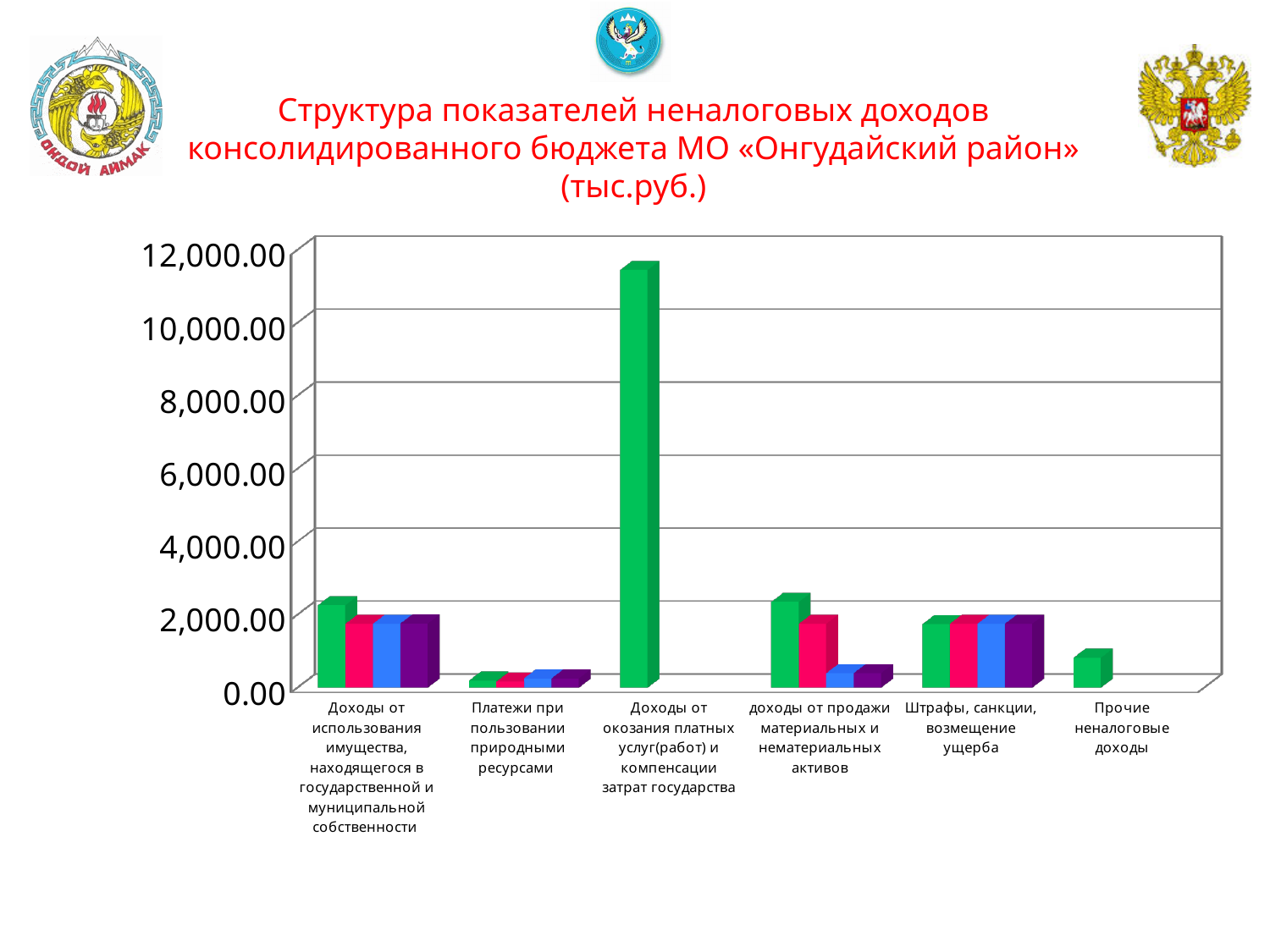
Is the green bar for 'Доходы от использования имущества, находящегося в государственной и муниципальной собственности' greater or less than 4,000.00? less Which category has the shortest green bar in the chart? Платежи при пользовании природными ресурсами Is the green bar for 'Прочие неналоговые доходы' greater or less than 2,000.00? less Is the green bar for 'Доходы от оказания платных услуг(работ) и компенсации затрат государства' greater or less than 10,000.00? greater What colour is the tallest bar in the chart? green What kind of chart is shown on the slide? bar chart Which green bar is taller: 'Штрафы, санкции, возмещение ущерба' or 'Доходы от оказания платных услуг(работ) и компенсации затрат государства'? Доходы от оказания платных услуг(работ) и компенсации затрат государства How many categories are shown along the x axis of the chart? 6 Which green bar is taller: 'Прочие неналоговые доходы' or 'Платежи при пользовании природными ресурсами'? Прочие неналоговые доходы Which category has the tallest bar in the chart? Доходы от окозания платных услуг(работ) и компенсации затрат государства What unit is given in parentheses in the chart title? тыс.руб.